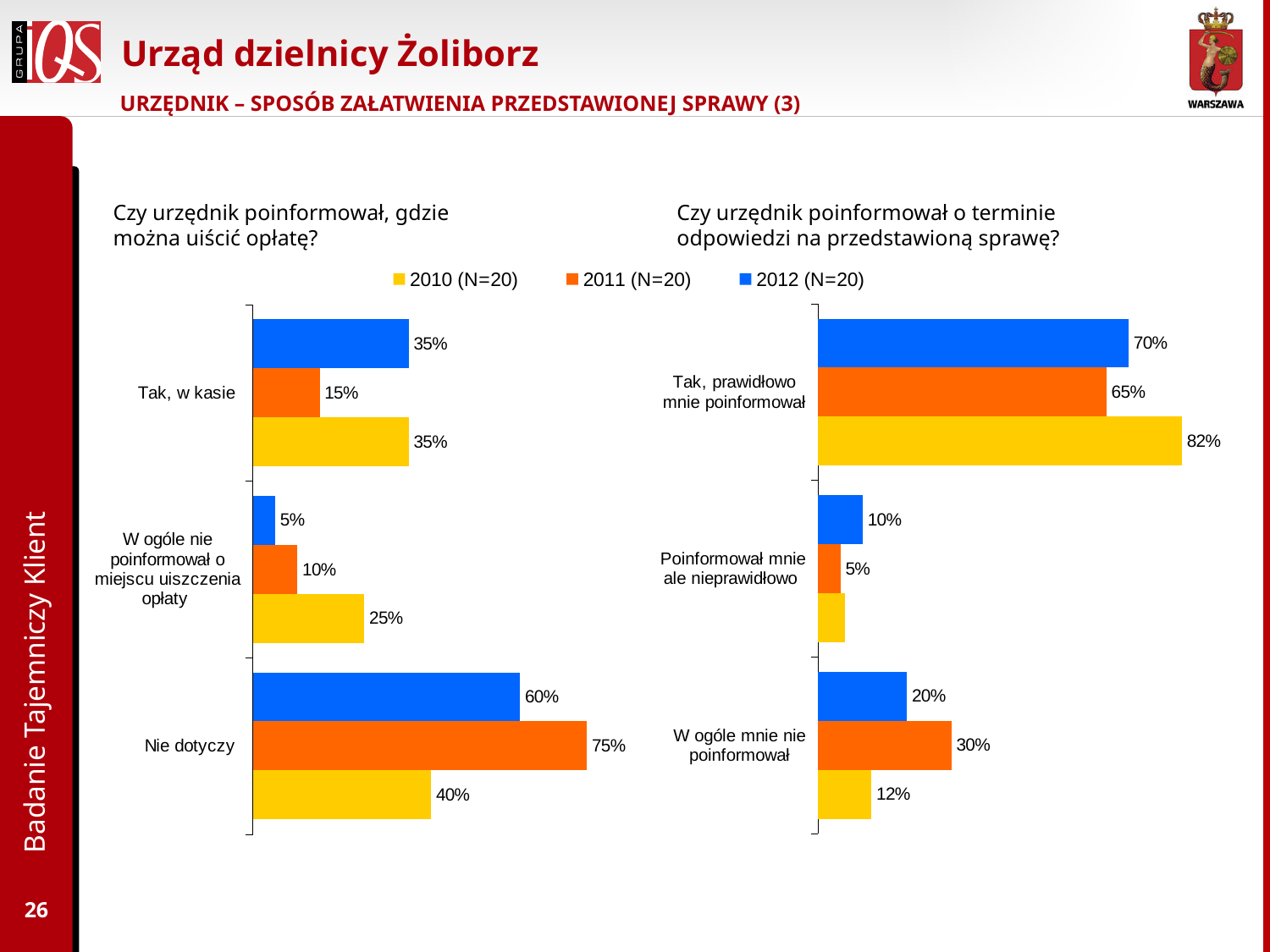
How many categories does the left chart (Czy urzędnik poinformował, gdzie można uiścić opłatę?) show? 3 In the right chart (Czy urzędnik poinformował o terminie odpowiedzi na przedstawioną sprawę?), what is the value for 'Tak, prawidłowo mnie poinformował' in 2010 (N=20)? 82% In the right chart (Czy urzędnik poinformował o terminie odpowiedzi na przedstawioną sprawę?), which category has the lowest value for 2012 (N=20)? Poinformował mnie ale nieprawidłowo In the left chart (Czy urzędnik poinformował, gdzie można uiścić opłatę?), what is the value for 'Nie dotyczy' in 2011 (N=20)? 75% In the left chart (Czy urzędnik poinformował, gdzie można uiścić opłatę?), what is the value for 'Tak, w kasie' in 2012 (N=20)? 35% In the left chart (Czy urzędnik poinformował, gdzie można uiścić opłatę?), what is the difference between the 2011 (N=20) and 2012 (N=20) values for 'Nie dotyczy'? 15% In the right chart (Czy urzędnik poinformował o terminie odpowiedzi na przedstawioną sprawę?), which is larger for 'W ogóle mnie nie poinformował': the 2011 (N=20) value or the 2012 (N=20) value? 2011 (N=20) In the left chart (Czy urzędnik poinformował, gdzie można uiścić opłatę?), which category has the highest value for 2012 (N=20)? Nie dotyczy In the right chart (Czy urzędnik poinformował o terminie odpowiedzi na przedstawioną sprawę?), what is the value for 'W ogóle mnie nie poinformował' in 2011 (N=20)? 30% In the right chart (Czy urzędnik poinformował o terminie odpowiedzi na przedstawioną sprawę?), what is the difference between the 2010 (N=20) and 2011 (N=20) values for 'Tak, prawidłowo mnie poinformował'? 17% What kind of chart is the right chart (Czy urzędnik poinformował o terminie odpowiedzi na przedstawioną sprawę?)? Bar chart How many series does the legend list? 3